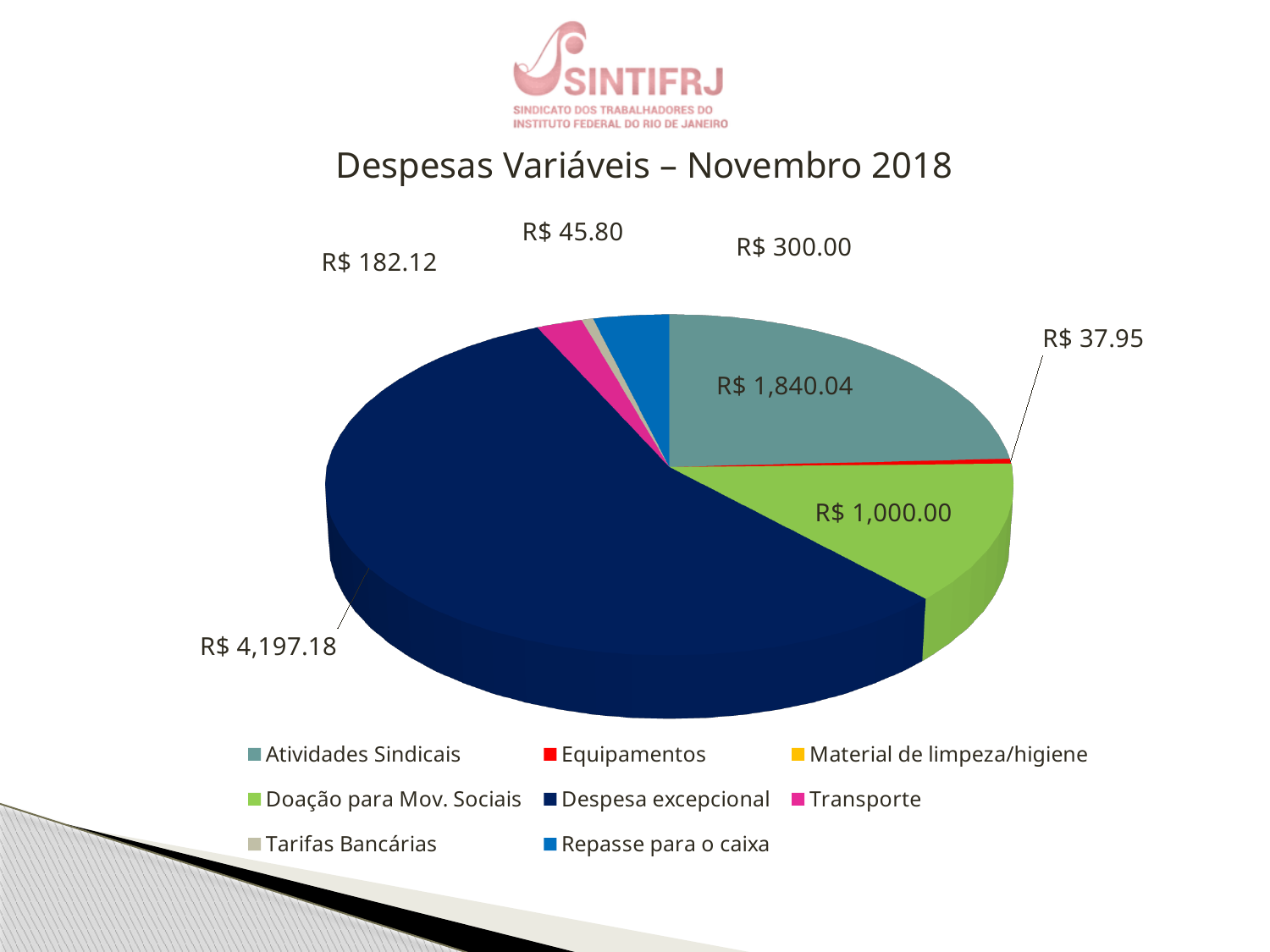
What is the value for Despesa excepcional? R$ 4,197.18 What is the value for Doação para Mov. Sociais? R$ 1,000.00 What is the value for Atividades Sindicais? R$ 1,840.04 What is the value for Equipamentos? R$ 37.95 Which is larger, Atividades Sindicais or Doação para Mov. Sociais? Atividades Sindicais What is the value for Repasse para o caixa? R$ 300.00 What kind of chart is shown on the slide? pie chart Which category has the largest slice of the pie? Despesa excepcional How many categories does the legend list? 8 What is the difference between Atividades Sindicais and Doação para Mov. Sociais? R$ 840.04 What is the title of the chart? Despesas Variáveis – Novembro 2018 What is the value for Transporte? R$ 182.12